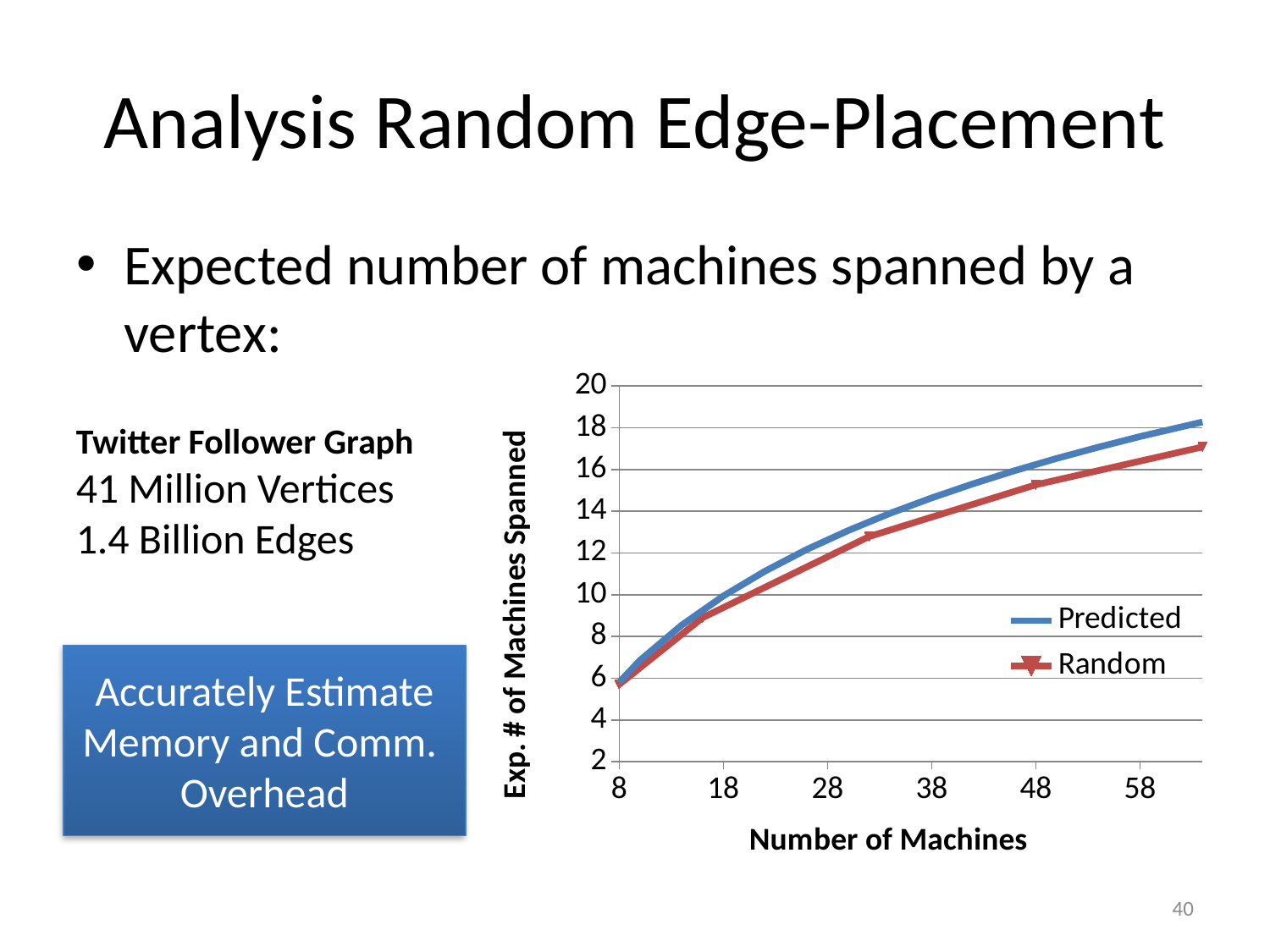
What kind of chart is shown on the slide? line chart At 28 machines, which series has the higher value, Predicted or Random? Predicted Do the values of the Random series rise or fall as the number of machines increases? rise Do the values of the Predicted series rise or fall as the number of machines increases? rise At 48 machines, which series has the higher value, Predicted or Random? Predicted Is the value of the Predicted series at 8 machines greater or less than 8? less How many series does the chart's legend list? 2 Is the value of the Random series at 18 machines greater or less than 10? less What are the names of the two series in the chart's legend? Predicted and Random What is the title of the chart's vertical axis? Exp. # of Machines Spanned Is the value of the Random series at 48 machines greater or less than 16? less